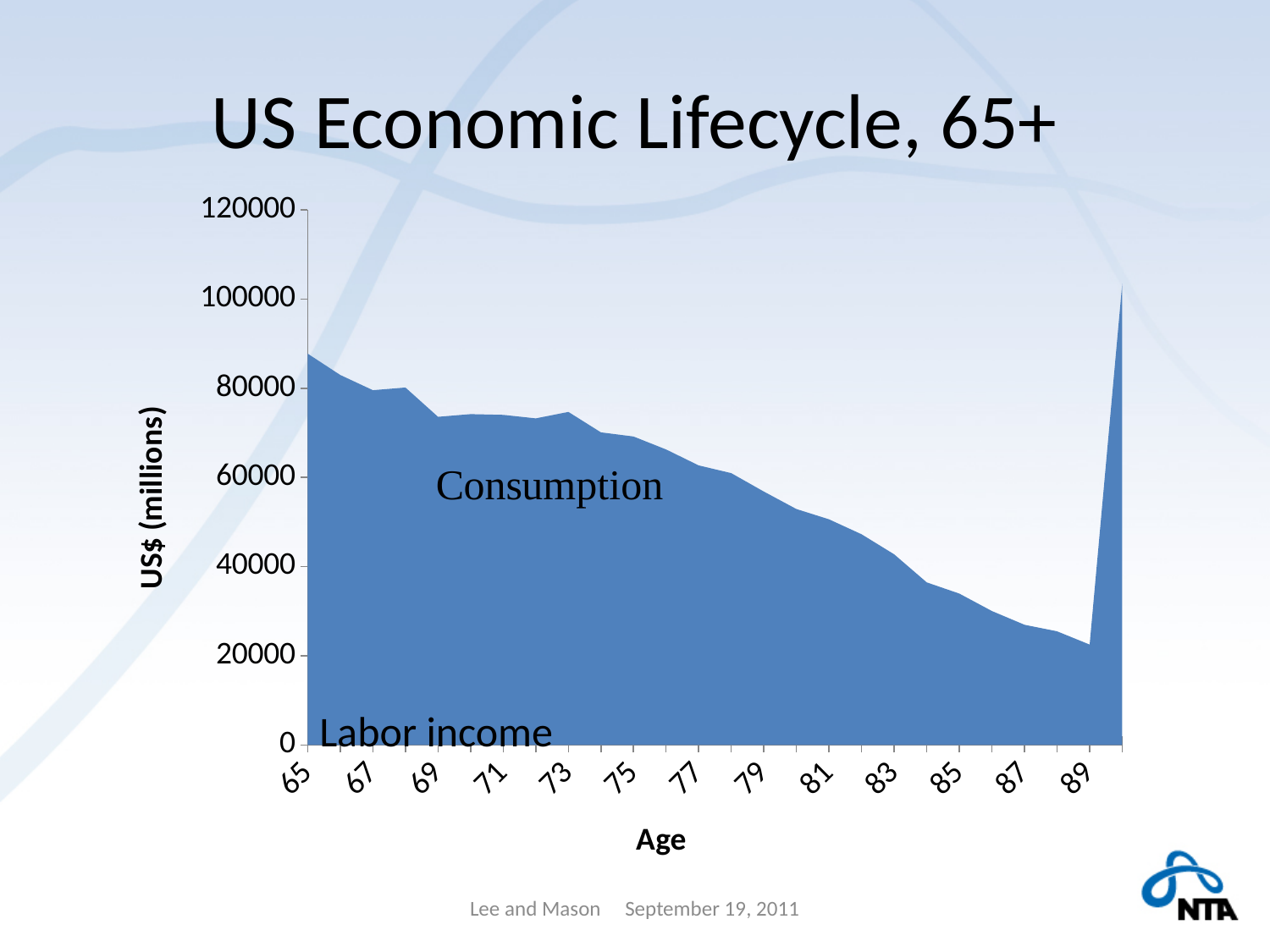
Is the value for age 71 greater or less than 80000? less Is the value for age 65 greater or less than 80000? greater How many age labels are shown on the x axis? 13 Is the value for age 85 greater or less than 40000? less What is the label on the vertical axis of the chart? US$ (millions) Do the values generally rise or fall as age increases from 65 to 89? fall What is the title of the chart? US Economic Lifecycle, 65+ What kind of chart is shown on the slide? area chart Among the labeled ages on the x axis, which age has the lowest value? 89